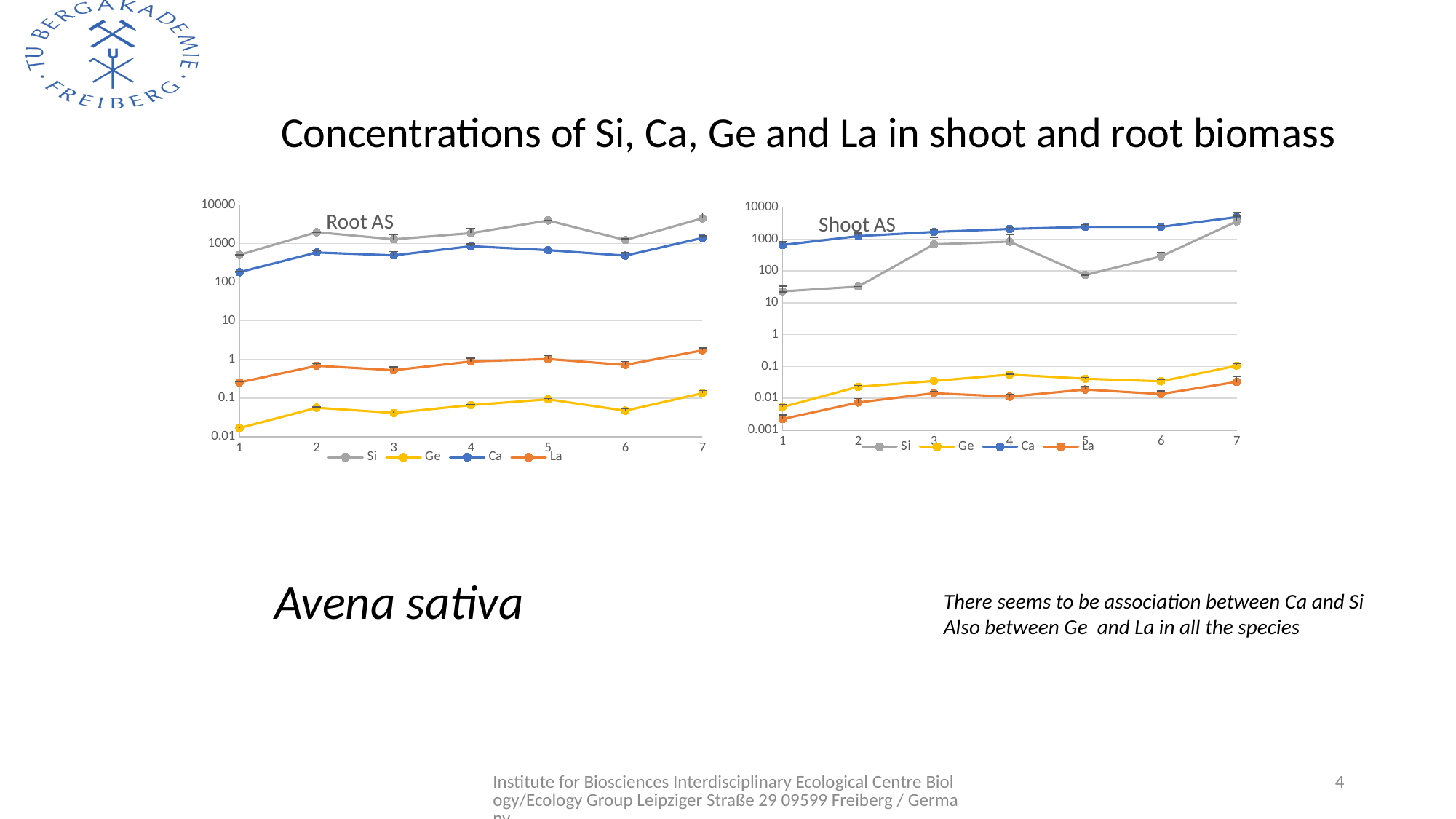
In the Shoot AS chart, does the Ca series generally rise or fall from point 1 to point 7? rise How many x-axis points are plotted in the Root AS chart? 7 In the Shoot AS chart, is the value for Ca at point 1 greater or less than 1000? less In the Root AS chart, which series has the lowest values across all points? Ge In the Shoot AS chart, which series is highest at point 2? Ca What type of chart is the Root AS chart? line chart In the Root AS chart, is the value for Si at point 1 greater or less than 100? greater In the Root AS chart, which series has the highest values across all points? Si In the Root AS chart, which is larger at point 6, Si or Ca? Si What colour is the La series line in the Root AS chart? orange How many series does the legend of the Shoot AS chart list? 4